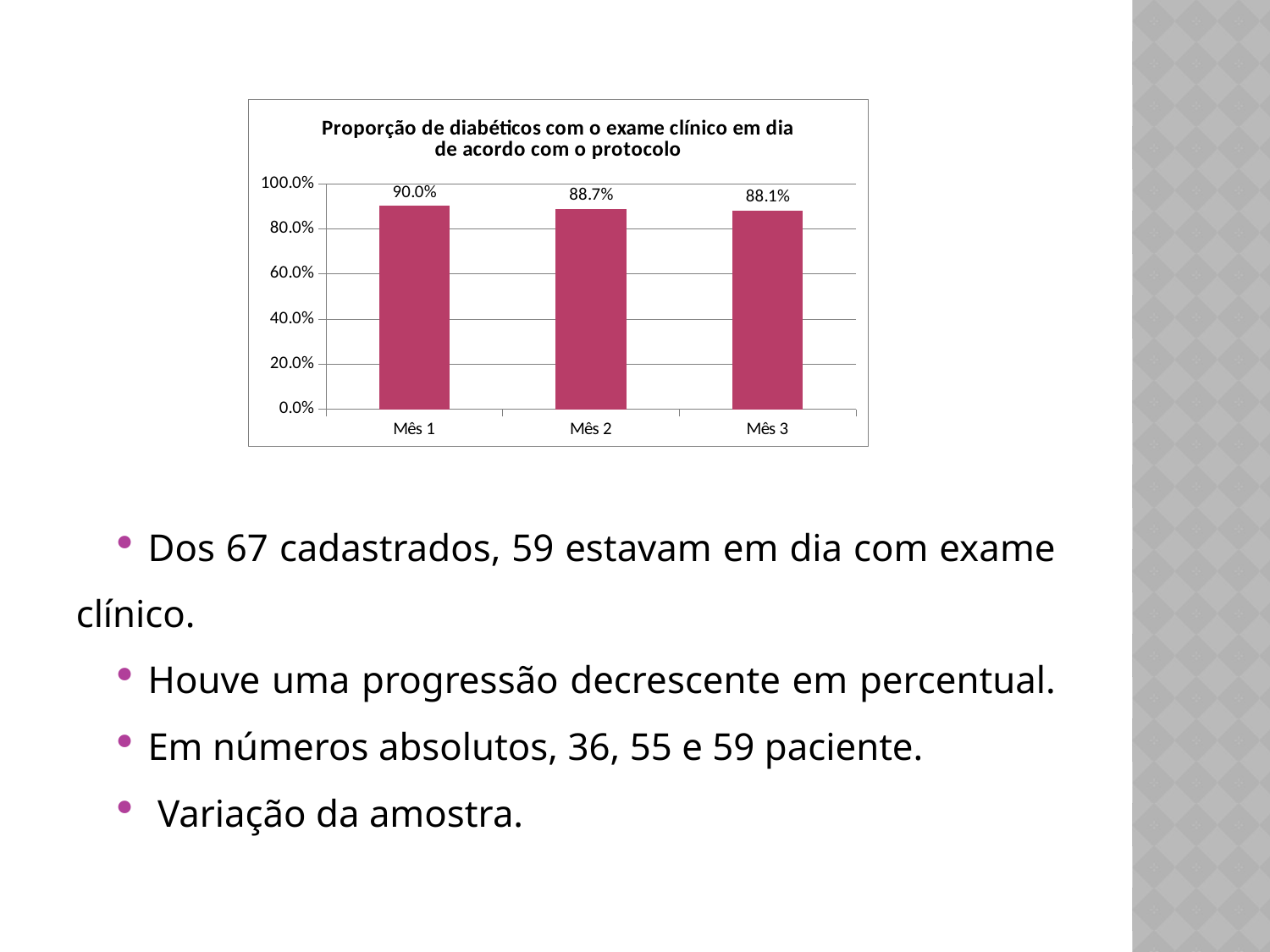
Do the values rise or fall from Mês 1 to Mês 3? fall How many months are shown on the x axis? 3 Is the value for Mês 2 greater or less than 80.0%? greater What is the title of the chart? Proporção de diabéticos com o exame clínico em dia de acordo com o protocolo What is the value for Mês 2? 88.7% What is the value for Mês 3? 88.1% What kind of chart is shown? bar chart What is the difference between the values for Mês 1 and Mês 3? 1.9% Which month has the highest value? Mês 1 What is the value for Mês 1? 90.0% What is the difference between the values for Mês 1 and Mês 2? 1.3% Which month has the lowest value? Mês 3